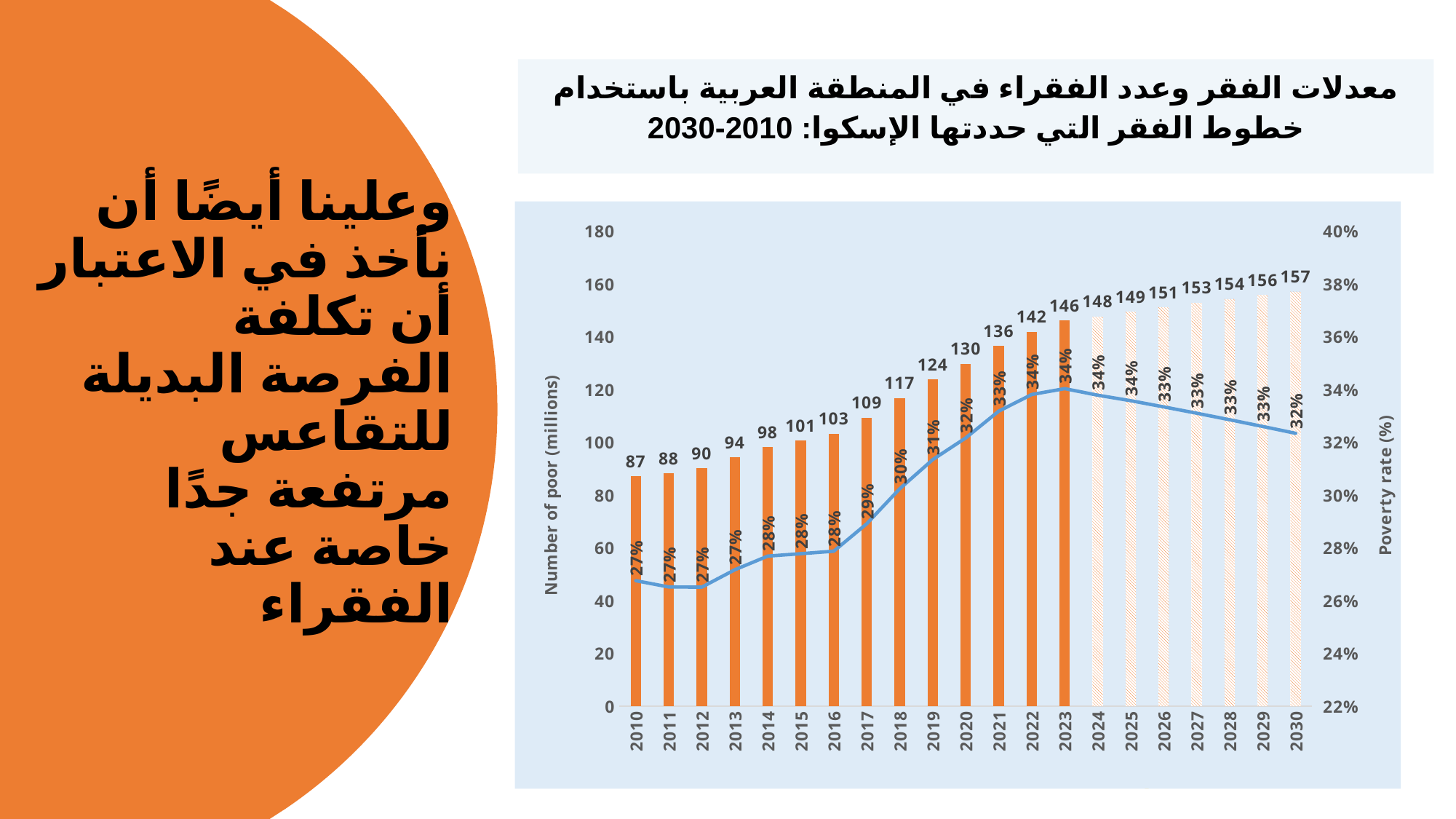
Which year has the highest number of poor (millions)? 2030 What is the number of poor (millions) shown for 2023? 146 What poverty rate is shown for 2030? 32% What is the number of poor (millions) shown for 2010? 87 Is the number of poor (millions) for 2016 greater or less than 100? greater Do the bars for the number of poor (millions) rise or fall from 2010 to 2030? Rise What poverty rate is shown for 2018? 30% Which year has the lowest number of poor (millions)? 2010 What is the difference in the number of poor (millions) between 2030 and 2010? 70 What kind of chart is shown on the slide? Combined bar and line chart How many years are shown on the x axis of the chart? 21 Which year has a larger number of poor (millions), 2017 or 2020? 2020